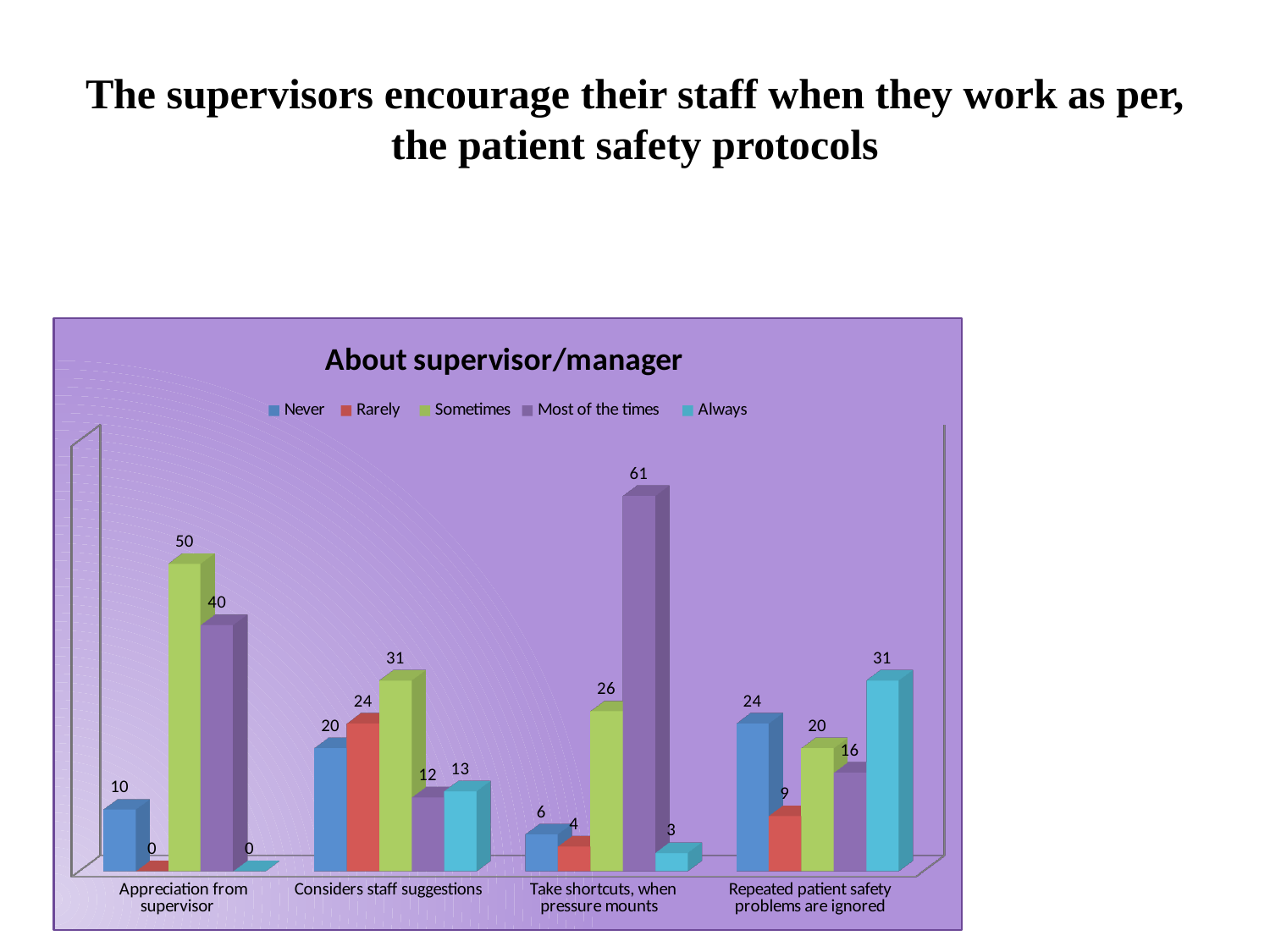
What kind of chart is shown on the slide? Bar chart How many categories are shown on the x axis of the chart? 4 Which is larger in the "Considers staff suggestions" category: the "Never" value or the "Rarely" value? Rarely What is the title of the chart? About supervisor/manager What is the value for "Rarely" in the "Considers staff suggestions" category? 24 What is the value for "Sometimes" in the "Appreciation from supervisor" category? 50 Which series has the lowest value in the "Repeated patient safety problems are ignored" category? Rarely How many series does the legend list? 5 What is the value for "Most of the times" in the "Take shortcuts, when pressure mounts" category? 61 What is the difference between the "Sometimes" and "Most of the times" values in the "Appreciation from supervisor" category? 10 Which series has the highest value in the "Take shortcuts, when pressure mounts" category? Most of the times What is the value for "Always" in the "Repeated patient safety problems are ignored" category? 31